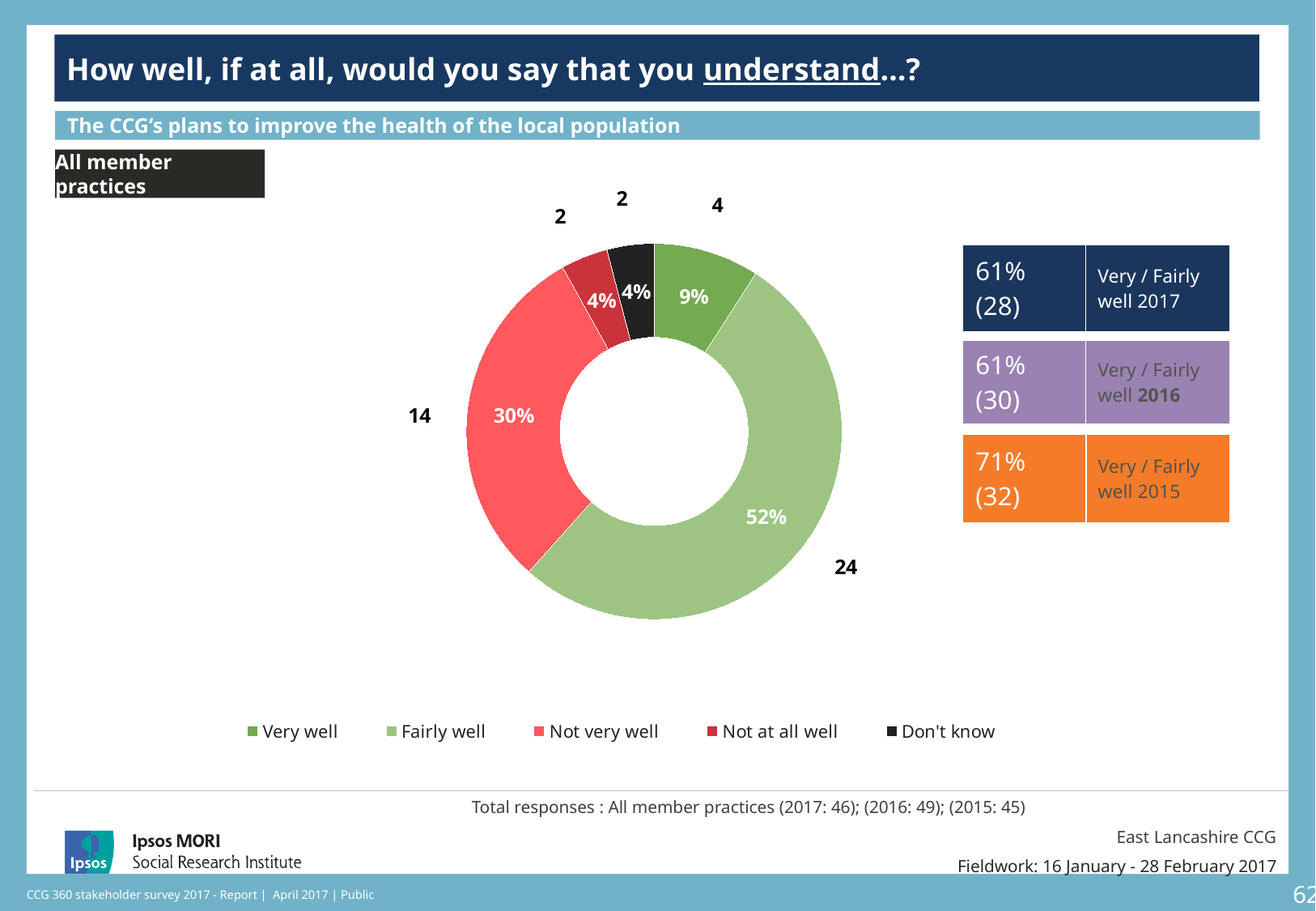
What percentage of respondents answered 'Very well'? 9% How many respondents (count) answered 'Not very well'? 14 What is the combined percentage for 'Very well' and 'Fairly well' in 2017, as shown in the box to the right of the chart? 61% What percentage of respondents answered 'Not very well'? 30% What is the difference in percentage points between 'Fairly well' and 'Not very well'? 22 Which response category has the largest share of the doughnut chart? Fairly well How many response categories does the legend list? 5 Which is larger, the share for 'Very well' or the share for 'Not very well'? Not very well What type of chart is used to show the responses? Doughnut chart What percentage of respondents said they understand the CCG's plans 'Fairly well'? 52% What colour represents 'Don't know' in the chart? Black What was the 'Very / Fairly well' percentage in 2015? 71%